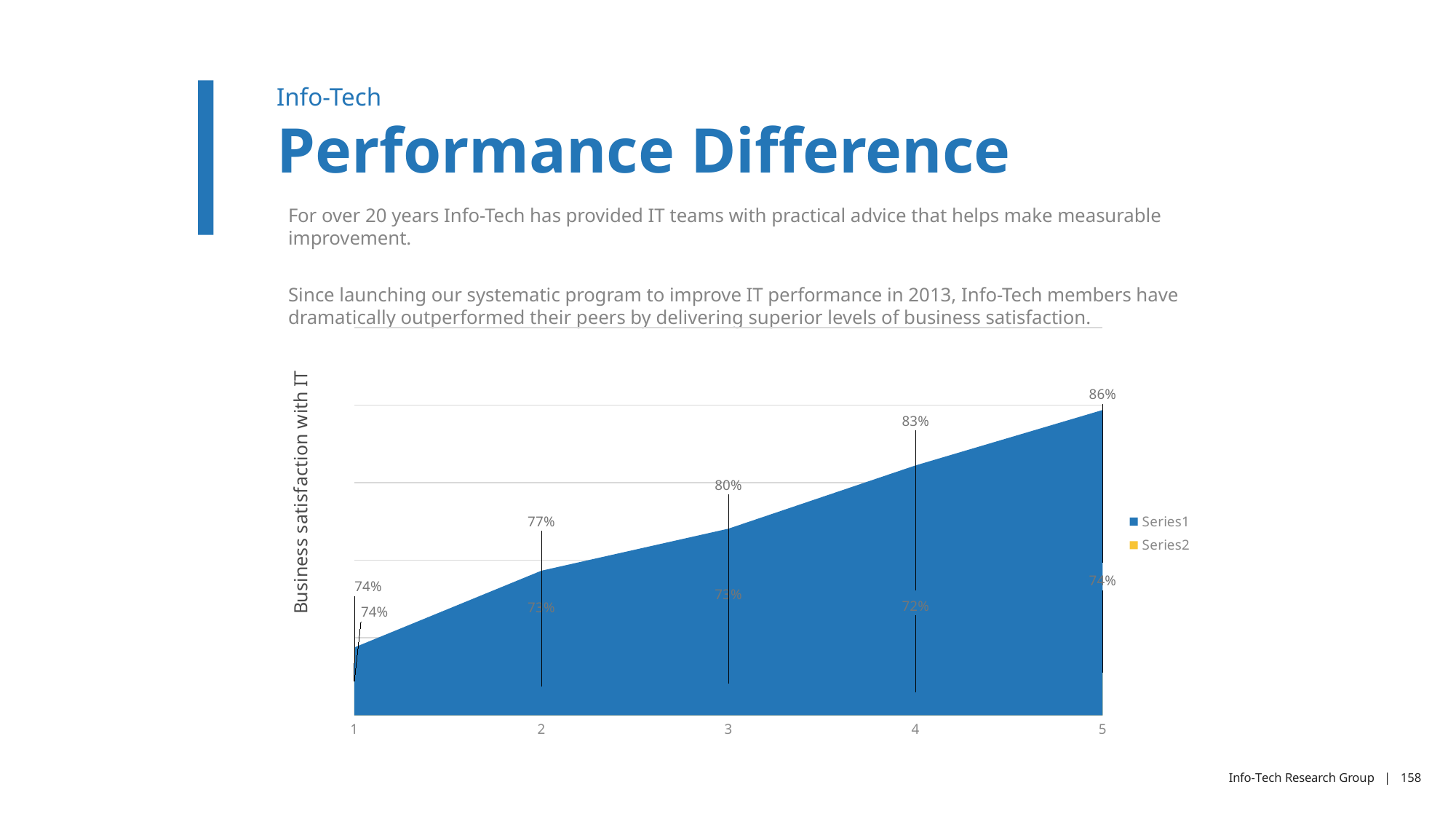
What is the difference between the Series1 values at category 5 and category 1? 12% At which category is the Series1 value lowest? 1 What is the Series1 value at category 5? 86% What is the Series1 value at category 1? 74% What is the difference between the Series1 values at category 4 and category 2? 6% Do the Series1 values rise or fall from category 1 to category 5? rise What is the Series1 value at category 3? 80% How many categories are shown on the x axis? 5 Which is larger for Series1: the value at category 2 or the value at category 4? category 4 What kind of chart is shown on the slide? area chart How many series does the legend list? 2 At which category does Series1 reach its highest value? 5